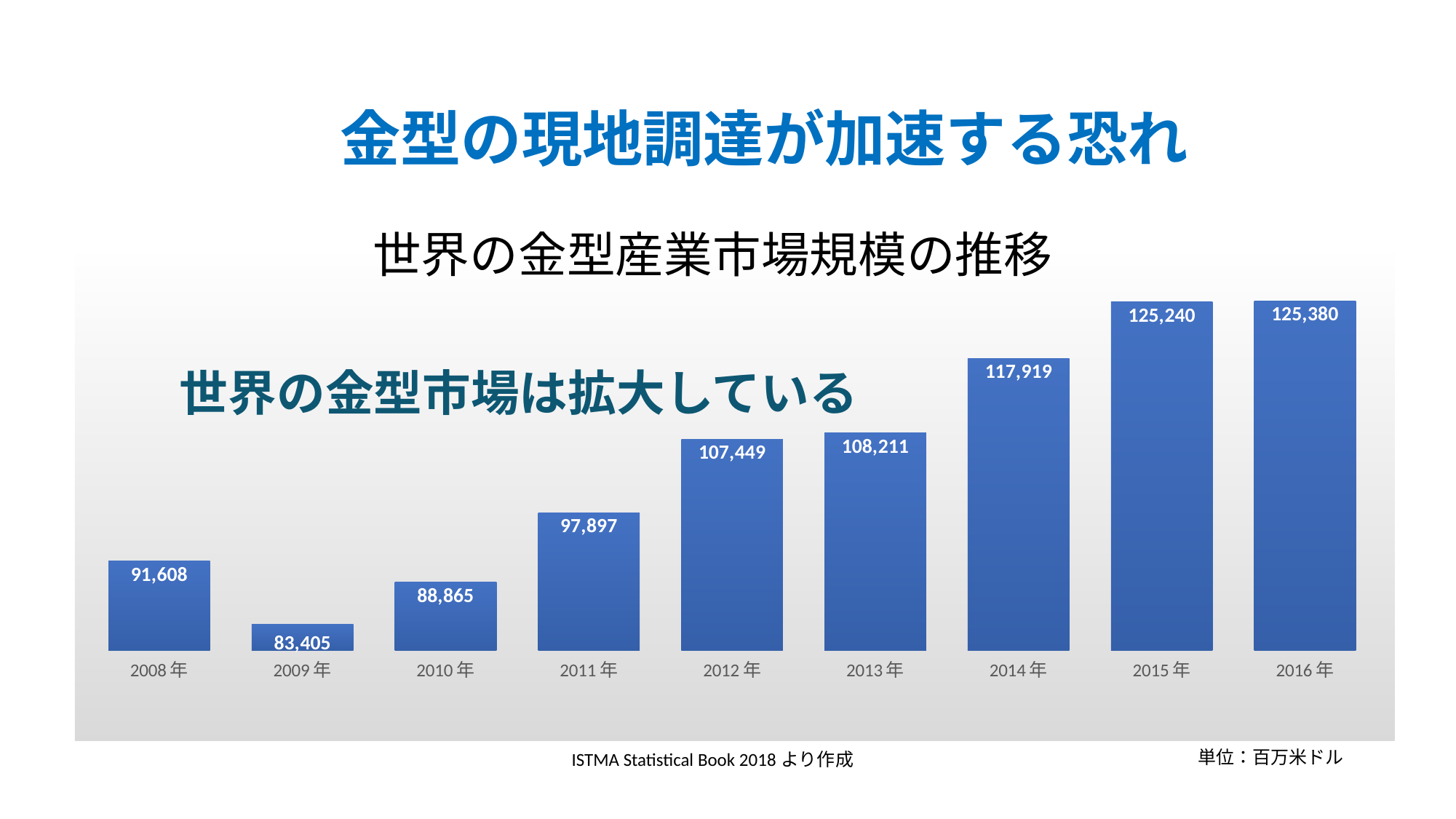
What is the title of the chart? 世界の金型産業市場規模の推移 What is the value for 2016年 in the chart? 125,380 How many years (bars) are shown in the chart? 9 What is the difference between the values for 2014年 and 2013年? 9,708 What is the value for 2013年 in the chart? 108,211 Do the values generally rise or fall from 2009年 to 2016年? Rise Which year has the highest value in the chart? 2016年 Which year has the lowest value in the chart? 2009年 What kind of chart is shown on the slide? Bar chart Which is larger, the value for 2011年 or the value for 2010年? 2011年 What is the difference between the values for 2008年 and 2009年? 8,203 What is the value for 2008年 in the chart? 91,608